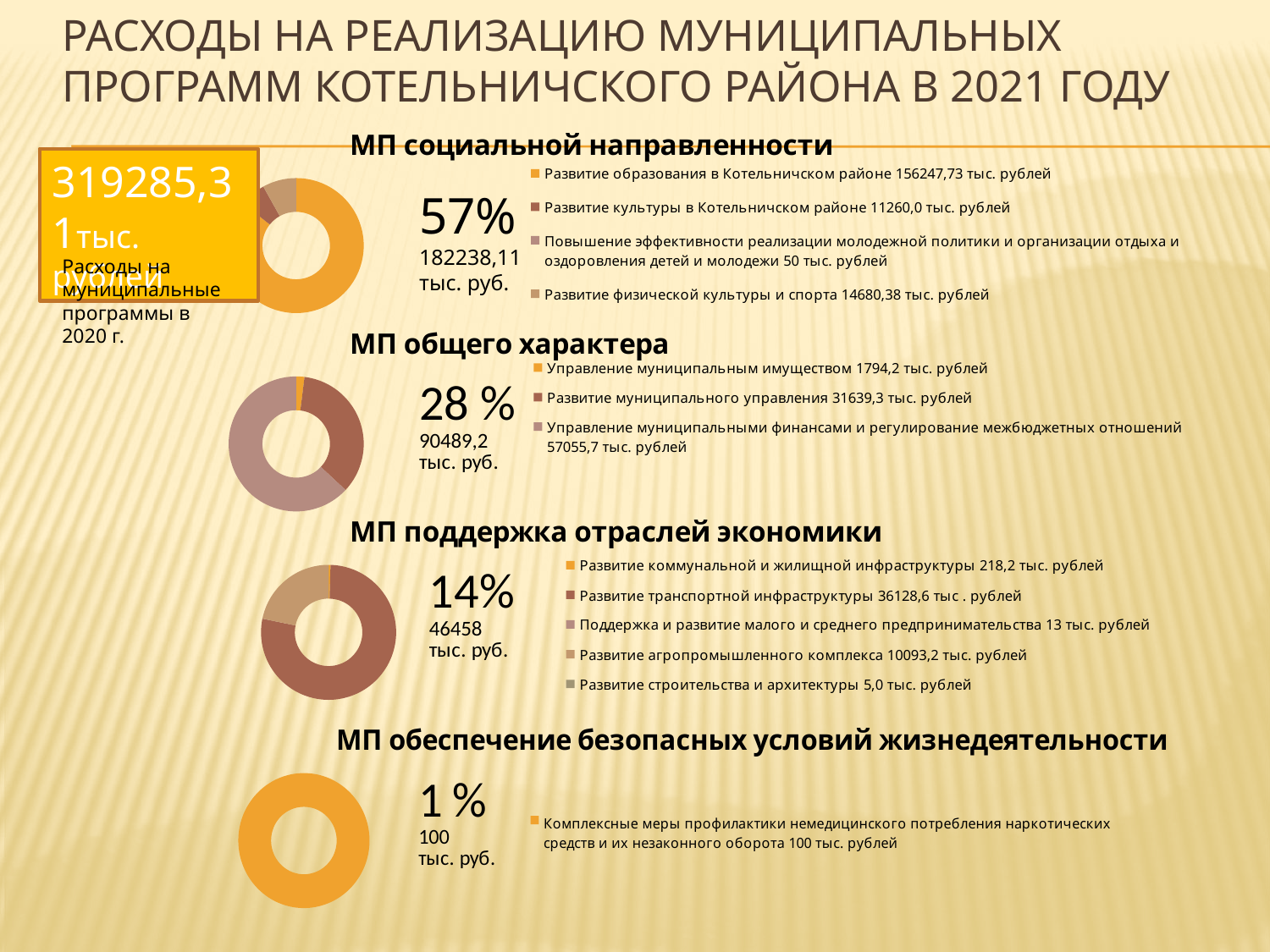
How many categories does the legend of the "МП общего характера" chart list? 3 In the "МП социальной направленности" chart, what is the value for "Развитие образования в Котельничском районе"? 156247,73 тыс. рублей What is the total value printed next to the "МП поддержка отраслей экономики" chart? 46458 тыс. руб. In the "МП общего характера" chart, what is the difference between "Управление муниципальными финансами и регулирование межбюджетных отношений" and "Развитие муниципального управления"? 25416,4 тыс. рублей How many categories does the legend of the "МП поддержка отраслей экономики" chart list? 5 What kind of chart is used for "МП социальной направленности"? Doughnut chart In the "МП общего характера" chart, which category has the highest value? Управление муниципальными финансами и регулирование межбюджетных отношений In the "МП поддержка отраслей экономики" chart, which is larger: "Развитие транспортной инфраструктуры" or "Развитие коммунальной и жилищной инфраструктуры"? Развитие транспортной инфраструктуры In the "МП социальной направленности" chart, which category has the lowest value? Повышение эффективности реализации молодежной политики и организации отдыха и оздоровления детей и молодежи What share of total expenditure does the "МП общего характера" chart represent, according to the percentage printed next to it? 28 % What is the value for "Комплексные меры профилактики немедицинского потребления наркотических средств и их незаконного оборота" in the "МП обеспечение безопасных условий жизнедеятельности" chart? 100 тыс. рублей In the "МП поддержка отраслей экономики" chart, what is the value for "Развитие агропромышленного комплекса"? 10093,2 тыс. рублей